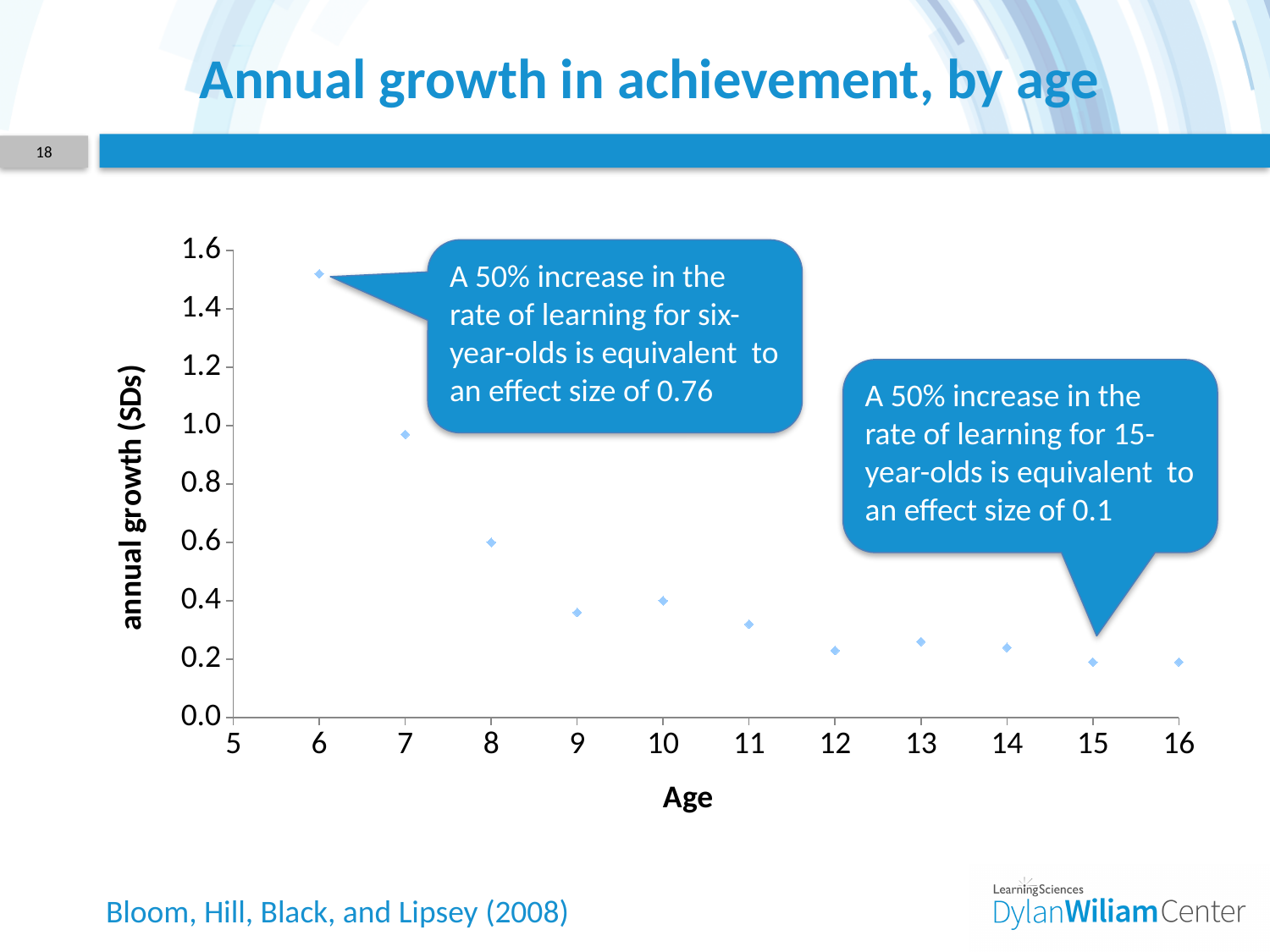
At which age is annual growth in achievement highest? 6 How many data points are plotted on the chart? 11 Which has the larger annual growth value, age 6 or age 7? age 6 What is the label on the vertical axis of the chart? annual growth (SDs) Overall, do the annual growth values rise or fall as age increases along the x axis? fall Is the annual growth value for age 6 greater or less than 1.4? greater Is the annual growth value for age 9 greater or less than 0.4? less Which has the larger annual growth value, age 8 or age 12? age 8 What kind of chart is shown on the slide? scatter chart Is the annual growth value for age 16 greater or less than 0.4? less